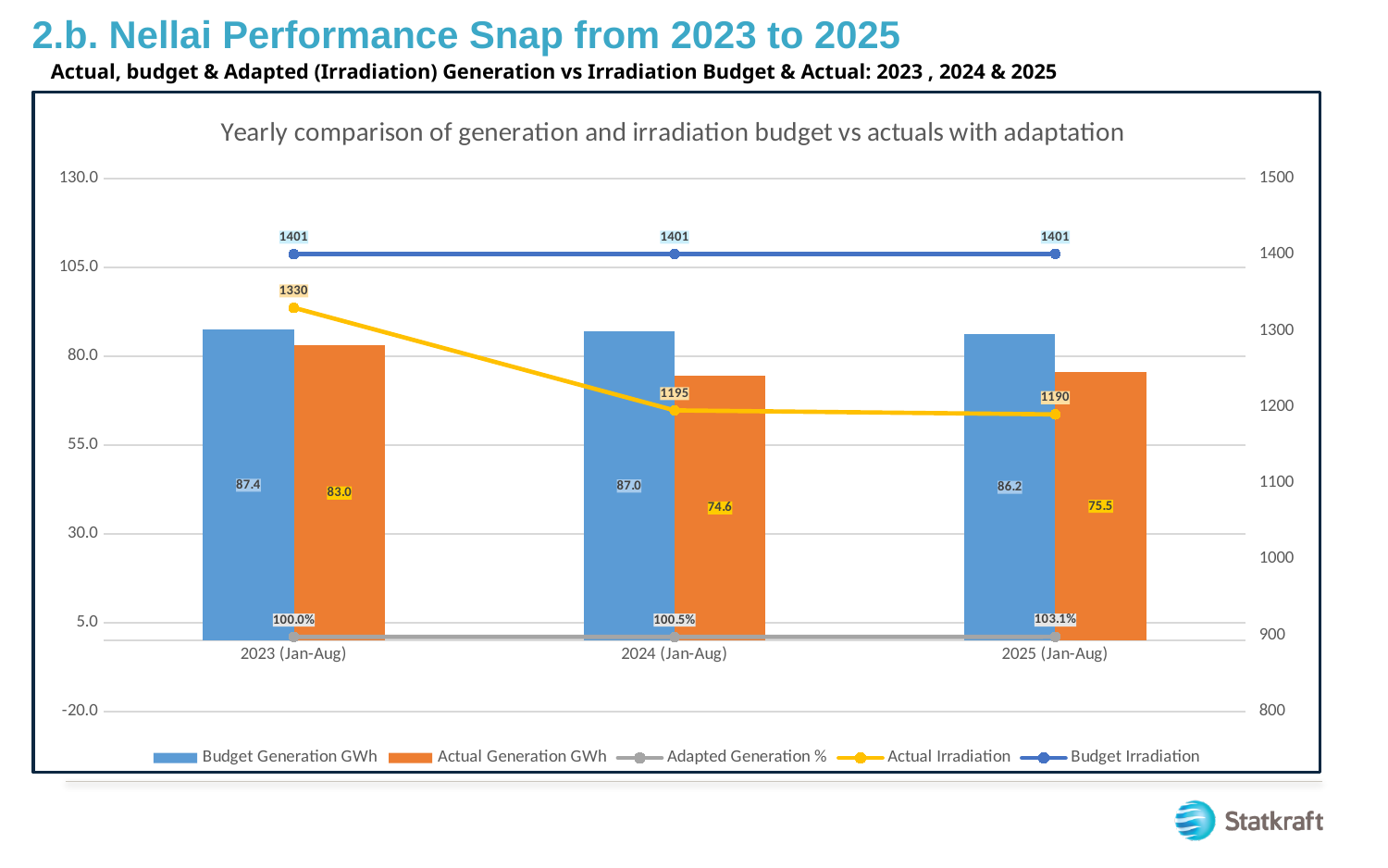
Which period has the lowest Actual Irradiation? 2025 (Jan-Aug) Does Actual Irradiation rise or fall from 2023 (Jan-Aug) to 2025 (Jan-Aug)? fall Which is larger in 2023 (Jan-Aug): Budget Irradiation or Actual Irradiation? Budget Irradiation How many series does the legend list? 5 What is the difference between Budget Generation GWh and Actual Generation GWh in 2024 (Jan-Aug)? 12.4 What is the Actual Irradiation value for 2025 (Jan-Aug)? 1190 What is the Budget Generation GWh value for 2023 (Jan-Aug)? 87.4 What is the Adapted Generation % value for 2025 (Jan-Aug)? 103.1% What is the Actual Generation GWh value for 2024 (Jan-Aug)? 74.6 What is the Budget Irradiation value for 2024 (Jan-Aug)? 1401 Which period has the highest Actual Generation GWh? 2023 (Jan-Aug) How many periods are shown on the x axis? 3